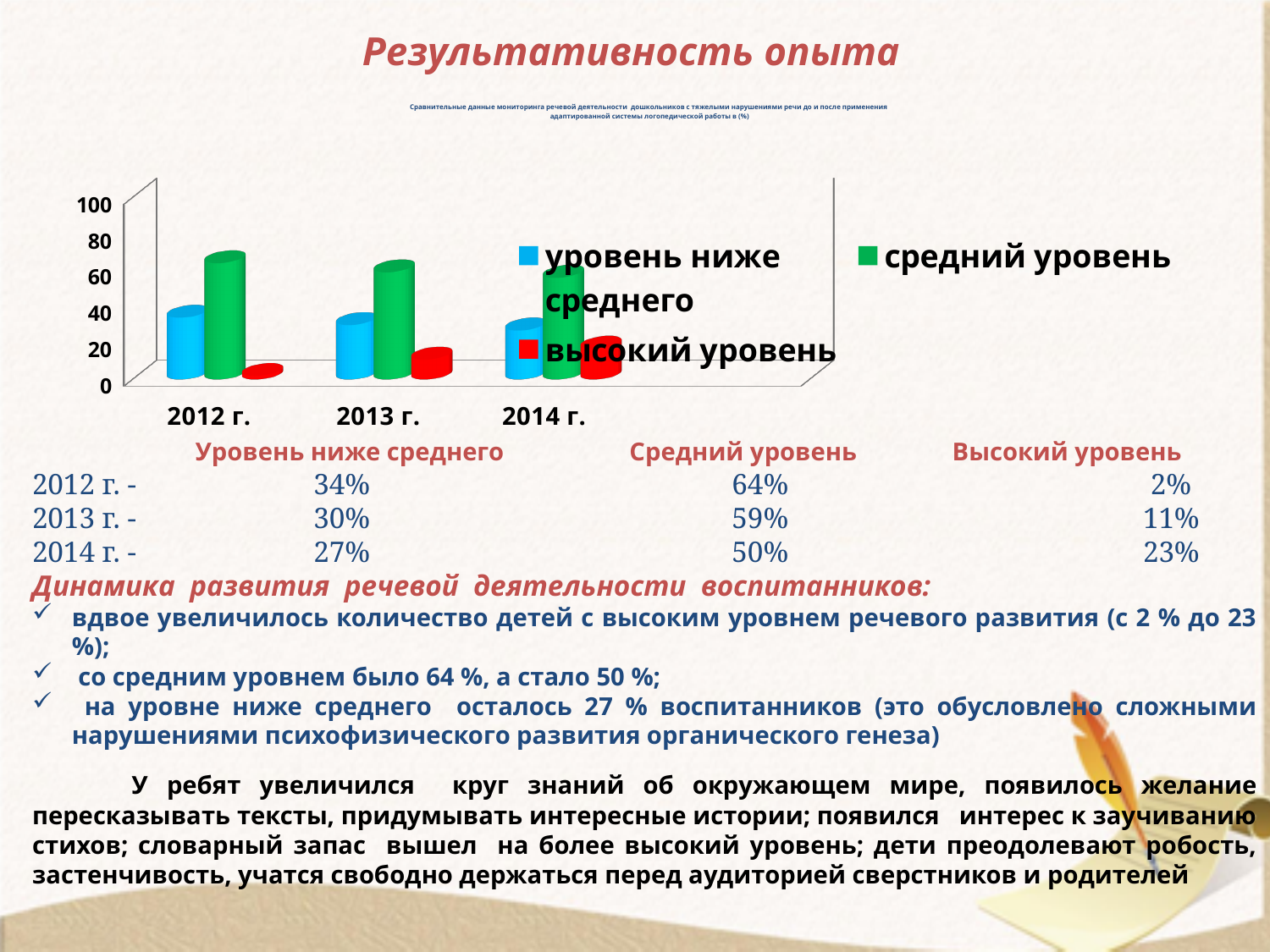
What is the value for 'высокий уровень' in 2014 г.? 23% In which year is the value for 'высокий уровень' the lowest? 2012 г. How many year categories are shown on the x axis of the chart? 3 Does the value for 'уровень ниже среднего' rise or fall from 2012 г. to 2014 г.? fall What is the difference between the 'средний уровень' values for 2012 г. and 2014 г.? 14% What is the value for 'средний уровень' in 2012 г.? 64% How many series does the chart legend list? 3 Is the value for 'средний уровень' in 2013 г. greater or less than 40? greater In which year is the value for 'средний уровень' the highest? 2012 г. Which series is shown in green in the chart legend? средний уровень What kind of chart is shown on the slide? bar chart What is the value for 'уровень ниже среднего' in 2013 г.? 30%